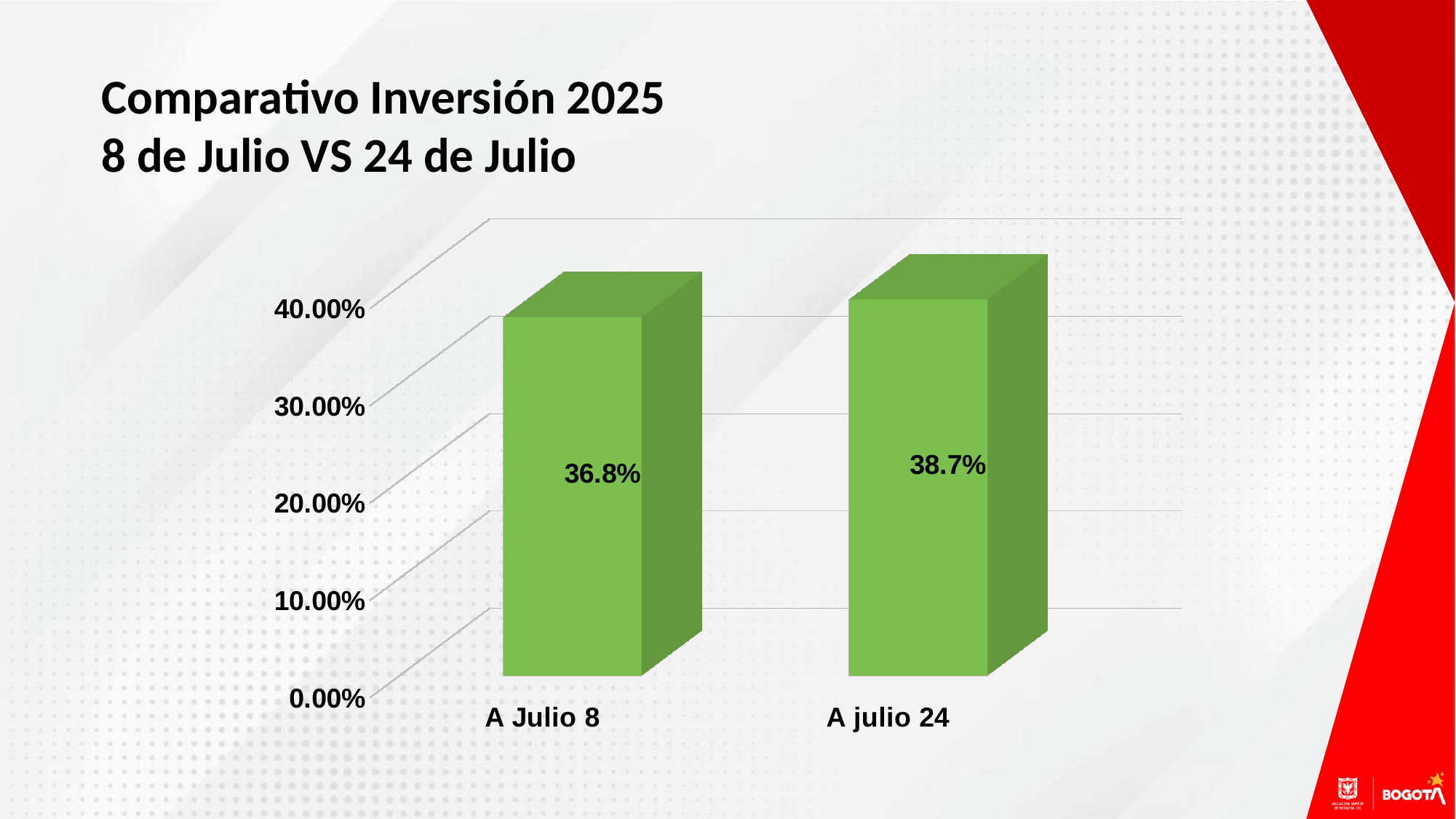
What is the difference between the values for A julio 24 and A Julio 8? 1.9% What kind of chart is shown on the slide? bar chart Do the values rise or fall from A Julio 8 to A julio 24? rise Which category has the lowest value? A Julio 8 Which is larger, the value for A Julio 8 or the value for A julio 24? A julio 24 Is the value for A Julio 8 greater or less than 30.00%? greater Is the value for A julio 24 greater or less than 40.00%? less How many categories are shown on the chart? 2 What is the value for A Julio 8? 36.8% Which category has the highest value? A julio 24 What is the value for A julio 24? 38.7% What is the title of the slide containing the chart? Comparativo Inversión 2025 8 de Julio VS 24 de Julio